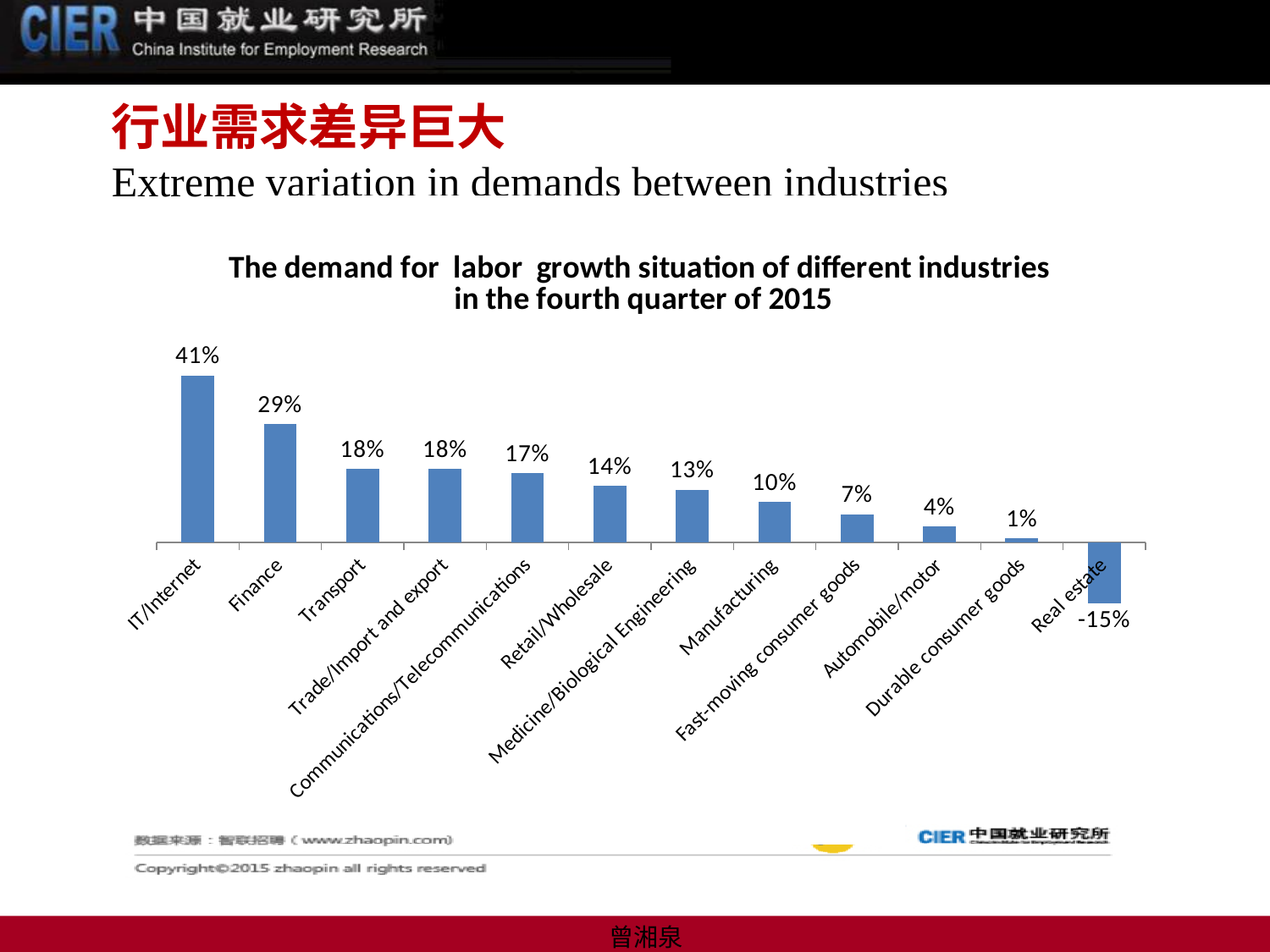
What is the value shown for Real estate? -15% Which industry has the lowest labor demand growth? Real estate Which has a larger value, Retail/Wholesale or Automobile/motor? Retail/Wholesale What is the value shown for Manufacturing? 10% Do the values rise or fall moving from left to right along the x axis? Fall What is the value shown for Finance? 29% Which industry has the highest labor demand growth? IT/Internet How many industries are shown in the chart? 12 What kind of chart is shown on the slide? Bar chart What is the labor demand growth value for IT/Internet? 41% What is the title of the chart? The demand for labor growth situation of different industries in the fourth quarter of 2015 What is the difference between the values for IT/Internet and Finance? 12%